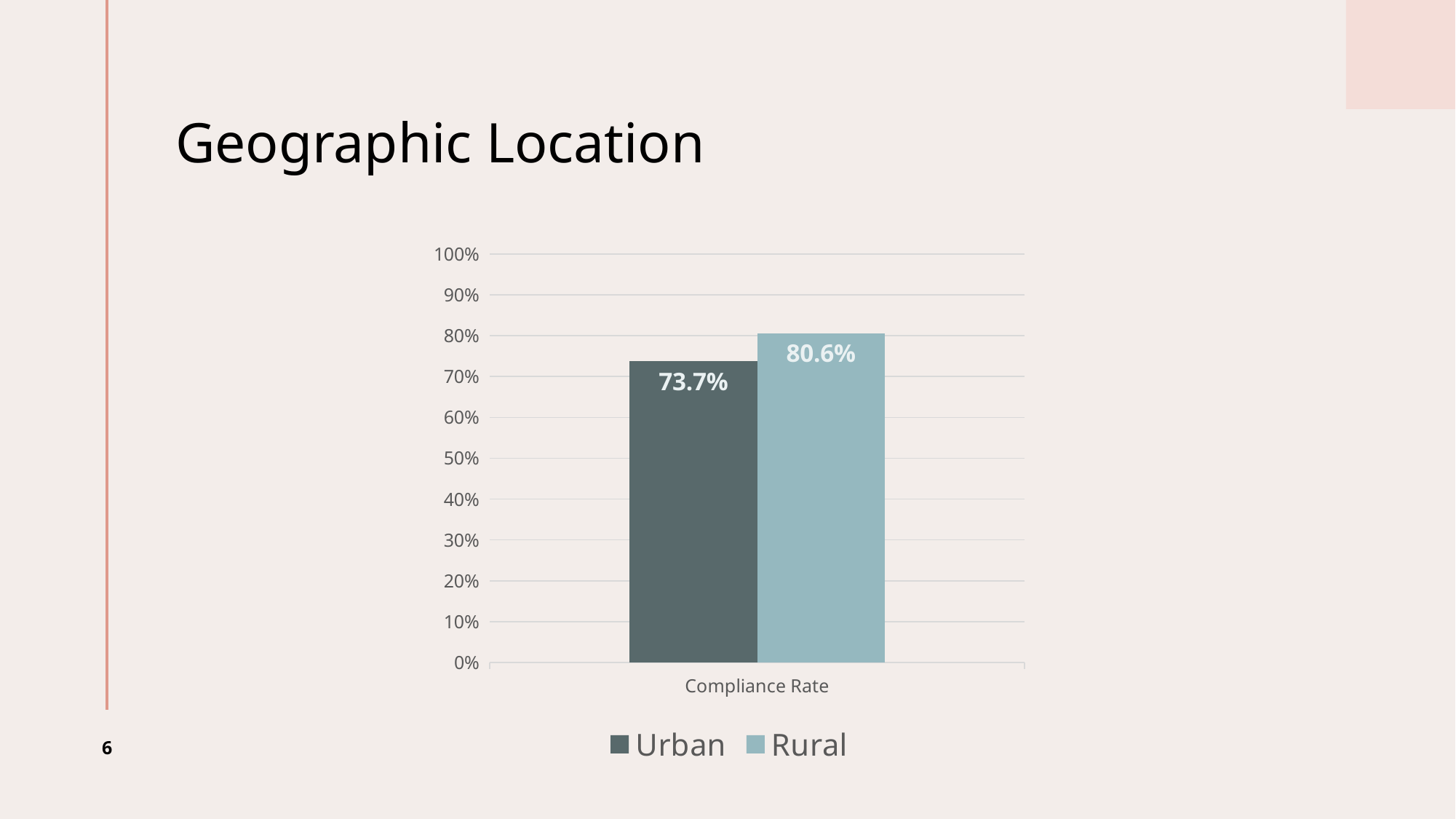
What is the title of the slide containing the chart? Geographic Location Is the compliance rate for Urban greater or less than 70%? greater Which series has the lowest compliance rate? Urban What is the compliance rate for Rural? 80.6% Which series has the higher compliance rate, Urban or Rural? Rural What is the category label on the x axis? Compliance Rate What is the compliance rate for Urban? 73.7% How many series does the legend list? 2 What is the difference between the Rural and Urban compliance rates? 6.9% Which series has the highest compliance rate? Rural What kind of chart is shown on the slide? Bar chart Is the compliance rate for Rural greater or less than 90%? less